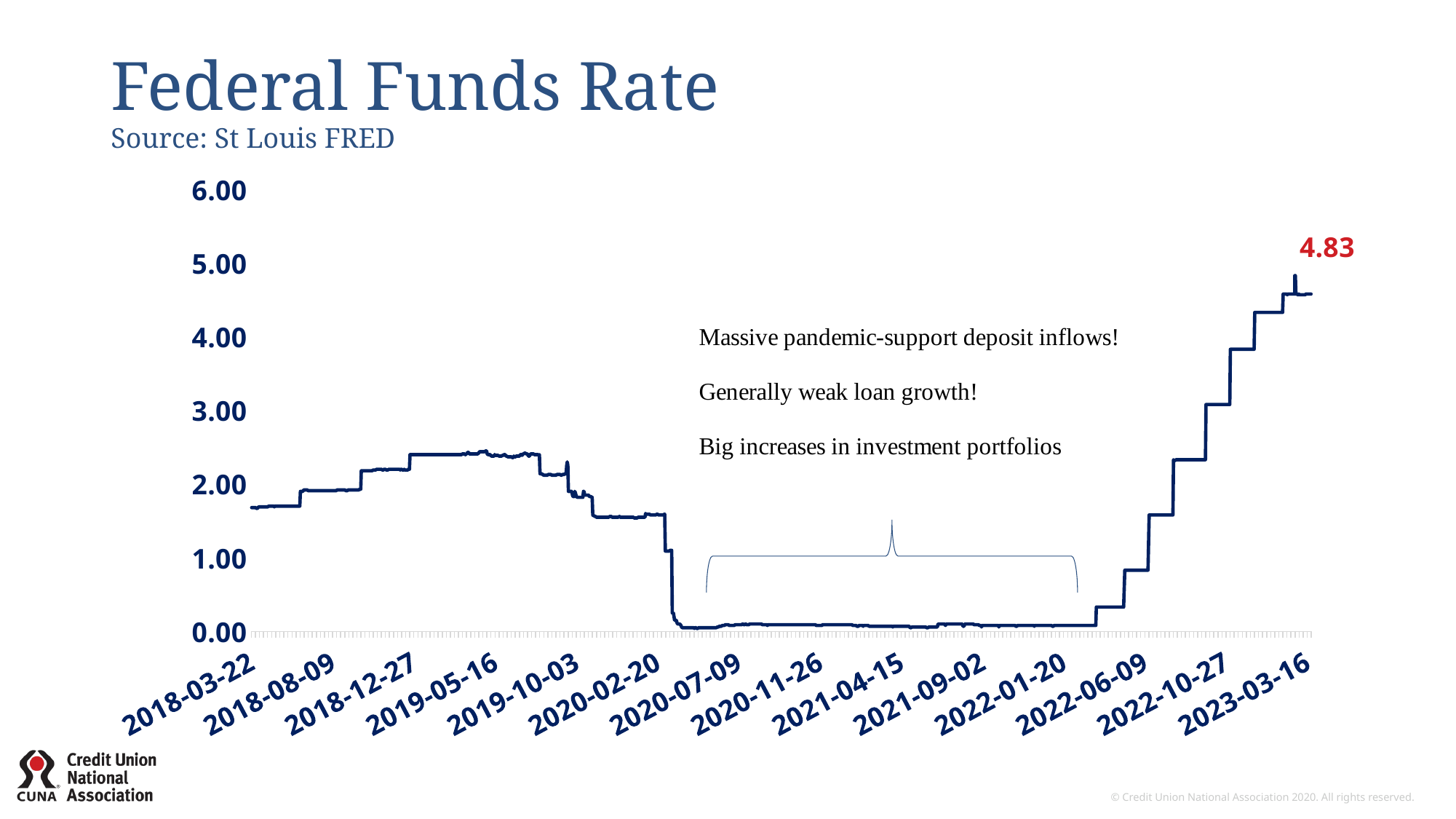
Does the line rise or fall between 2019-10-03 and 2020-07-09? falls What kind of chart is shown on the slide? line chart What is the title of the chart? Federal Funds Rate Which is larger, the value around 2019-05-16 or the value around 2021-04-15? 2019-05-16 Is the value around 2022-06-09 greater or less than 2.00? less What source is cited for the chart data? St Louis FRED Is the value around 2021-04-15 greater or less than 1.00? less Is the value around 2019-05-16 greater or less than 2.00? greater How many date labels are shown on the x axis? 14 Does the line rise or fall between 2022-06-09 and 2023-03-16? rises What value is labelled at the end of the line, near 2023-03-16? 4.83